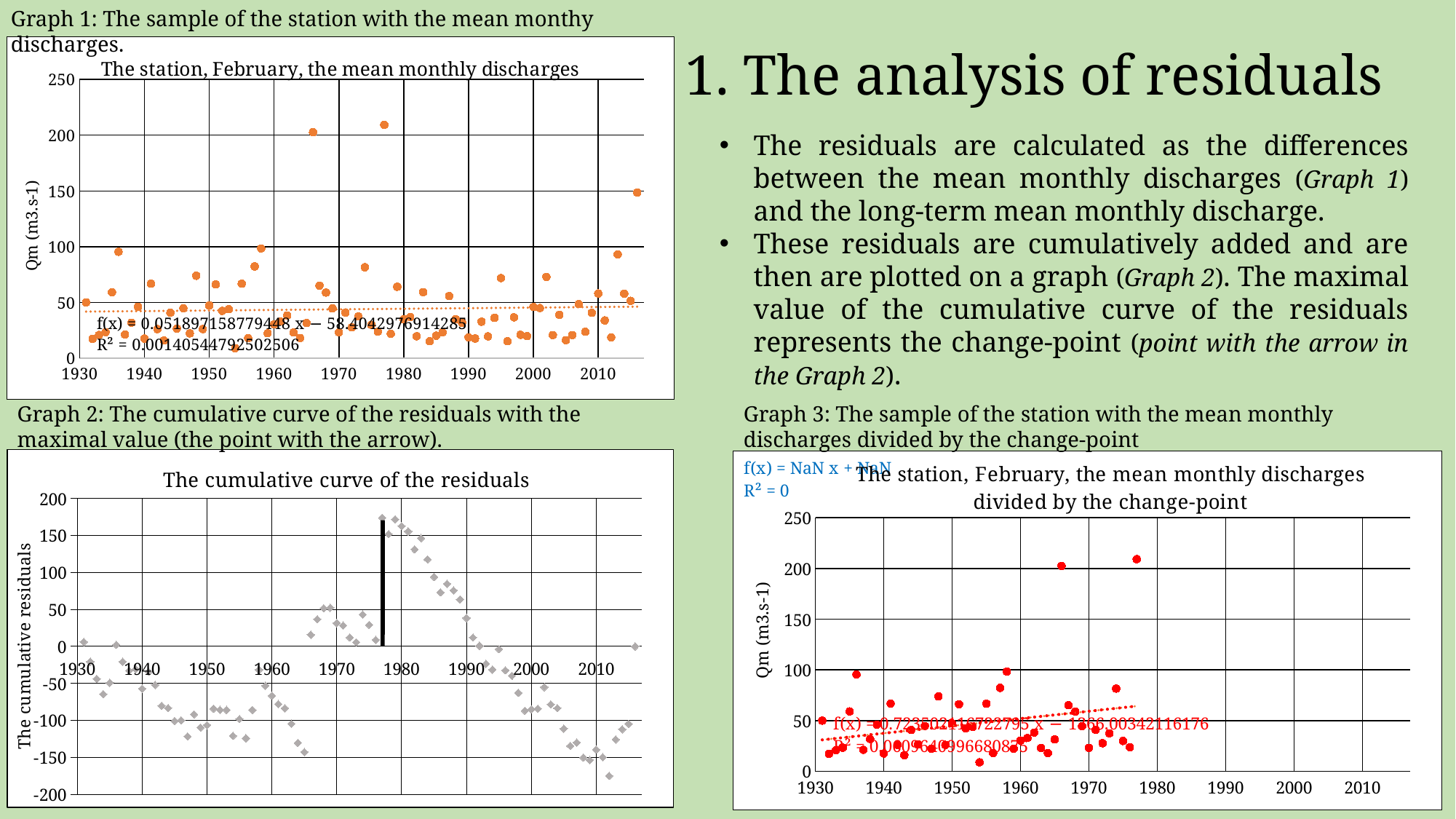
What is the title of the chart in Graph 2? The cumulative curve of the residuals What kind of chart is Graph 3 (the mean monthly discharges divided by the change-point)? scatter chart In Graph 2, is the maximal value of the cumulative curve (the point with the arrow) greater or less than 150? greater In Graph 3, is the highest plotted discharge (around 1977) greater or less than 150? greater What is the y-axis label of the chart in Graph 1? Qm (m3.s-1) In Graph 2, is the lowest plotted cumulative residual (around 2013) greater or less than -150? less What R² value is printed in blue text on the chart in Graph 3? 0 What kind of chart is Graph 1 (The station, February, the mean monthly discharges)? scatter chart In Graph 2, do the cumulative residuals rise or fall between 1980 and 2010? fall What R² value is printed on the chart in Graph 1? 0.00140544792502506